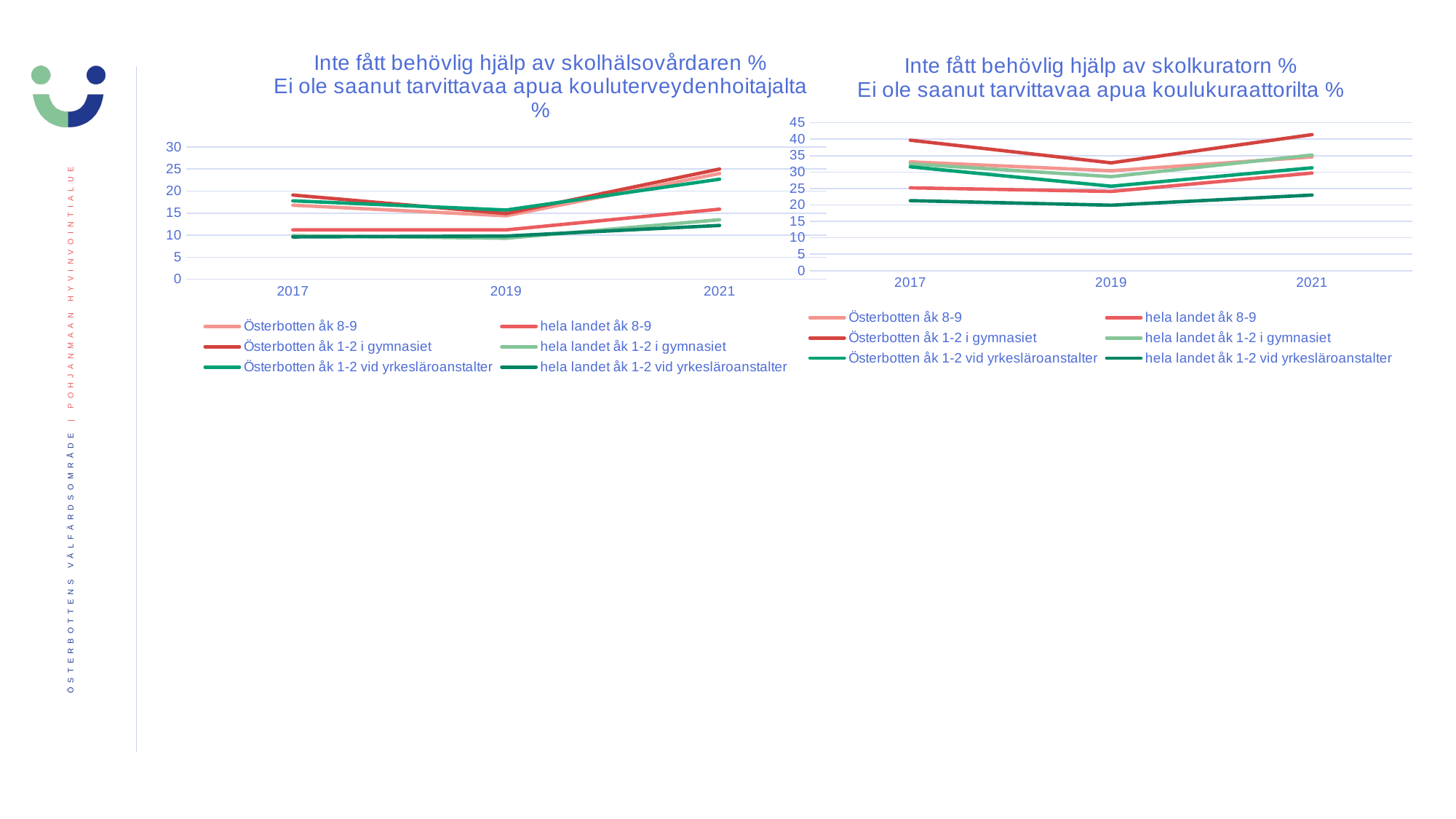
In the left chart, 'Inte fått behövlig hjälp av skolhälsovårdaren %', is the value for hela landet åk 1-2 vid yrkesläroanstalter in 2017 greater or less than 15? less In the left chart, 'Inte fått behövlig hjälp av skolhälsovårdaren %', which is larger in 2021: Österbotten åk 8-9 or hela landet åk 8-9? Österbotten åk 8-9 In the right chart, 'Inte fått behövlig hjälp av skolkuratorn %', which series has the highest value in 2021? Österbotten åk 1-2 i gymnasiet What kind of chart is the left chart, 'Inte fått behövlig hjälp av skolhälsovårdaren %'? line chart In the right chart, 'Inte fått behövlig hjälp av skolkuratorn %', which series has the lowest value in 2019? hela landet åk 1-2 vid yrkesläroanstalter How many series does the legend of the right chart, 'Inte fått behövlig hjälp av skolkuratorn %', list? 6 In the left chart, 'Inte fått behövlig hjälp av skolhälsovårdaren %', does the value for hela landet åk 8-9 rise or fall from 2019 to 2021? rise What is the highest value shown on the y axis of the right chart, 'Inte fått behövlig hjälp av skolkuratorn %'? 45 How many years are plotted on the x axis of the left chart, 'Inte fått behövlig hjälp av skolhälsovårdaren %'? 3 In the left chart, 'Inte fått behövlig hjälp av skolhälsovårdaren %', is the value for Österbotten åk 1-2 i gymnasiet in 2021 greater or less than 20? greater In the right chart, 'Inte fått behövlig hjälp av skolkuratorn %', is the value for hela landet åk 8-9 in 2019 greater or less than 30? less